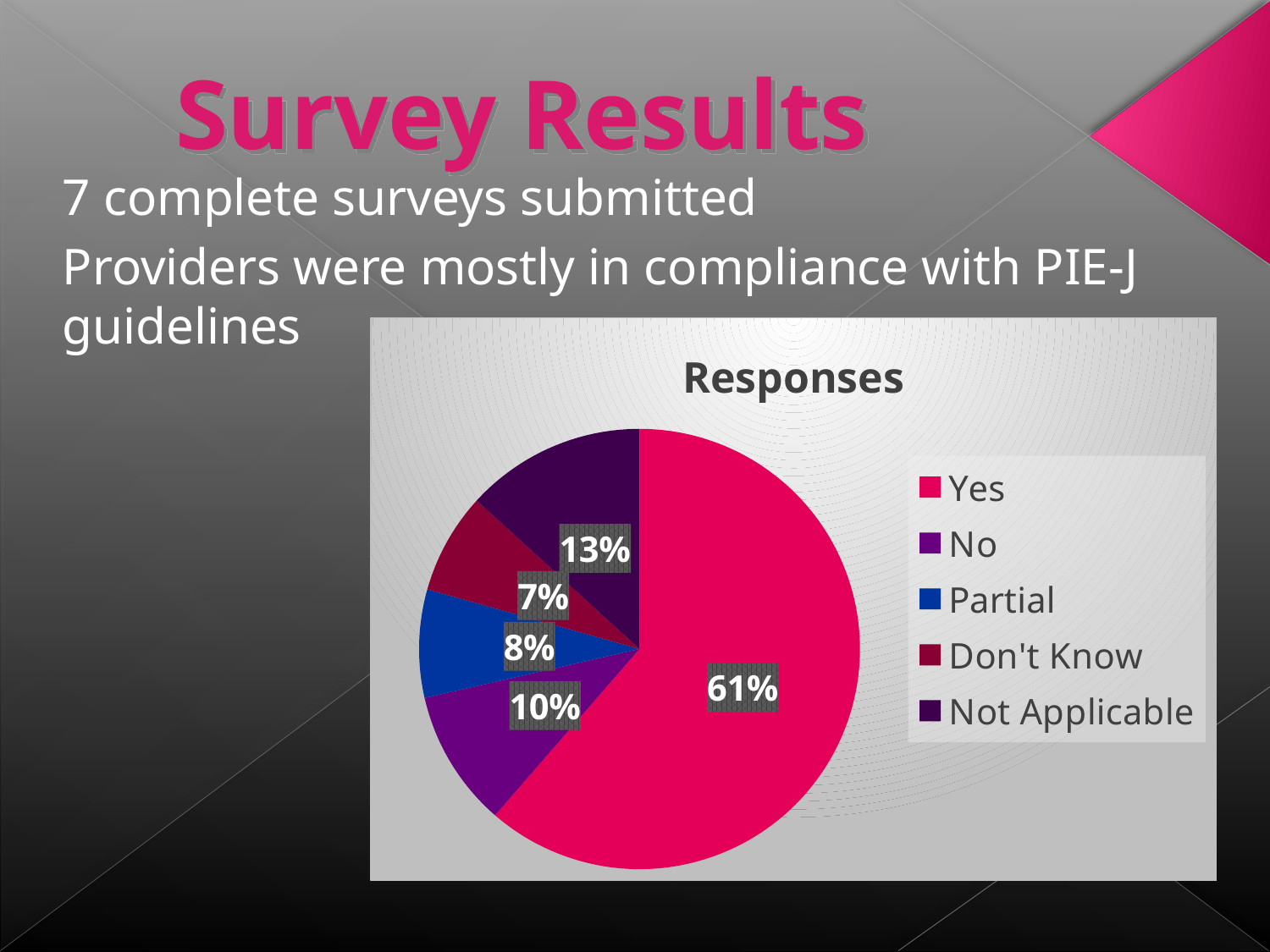
What share of the pie is labelled No? 10% What is the difference between the Yes share and the Not Applicable share? 48% What share of the pie is labelled Don't Know? 7% What share of the pie is labelled Yes? 61% What share of the pie is labelled Partial? 8% Which category has the smallest slice of the pie? Don't Know Which is larger, the No slice or the Partial slice? No How many categories does the legend list? 5 What kind of chart is shown on the slide? pie chart What is the title of the chart? Responses What share of the pie is labelled Not Applicable? 13% Which category has the largest slice of the pie? Yes